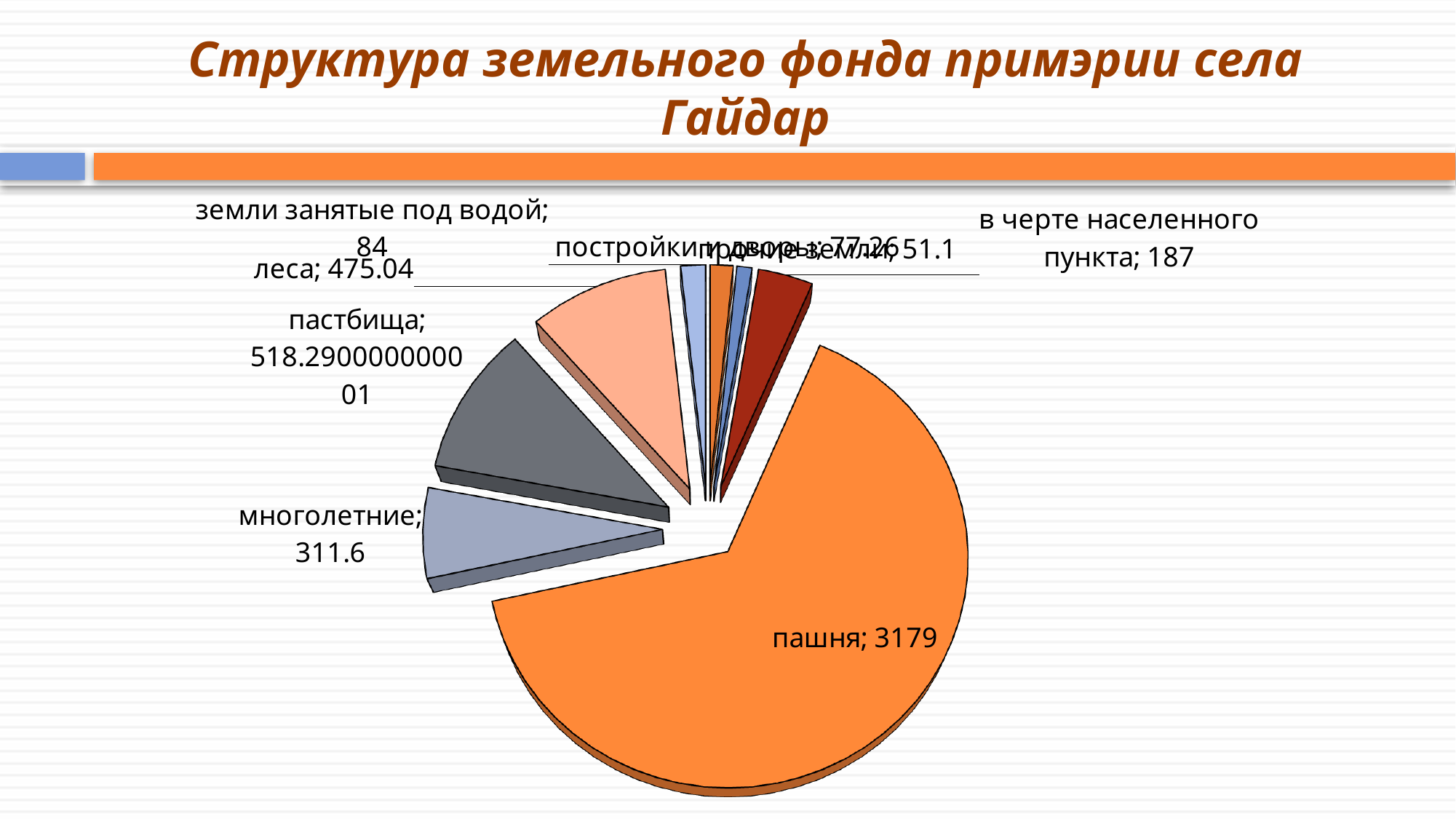
What is the value for многолетние? 311.6 Which is larger, многолетние or в черте населенного пункта? многолетние What is the title of the slide? Структура земельного фонда примэрии села Гайдар What is the value for в черте населенного пункта? 187 What is the difference between the values for пашня and многолетние? 2867.4 What type of chart is shown on the slide? pie chart What is the difference between the values for в черте населенного пункта and земли занятые под водой? 103 Which is larger, леса or пастбища? пастбища What is the value for леса? 475.04 What is the value for пашня? 3179 What is the value for земли занятые под водой? 84 Which category has the largest slice of the pie? пашня